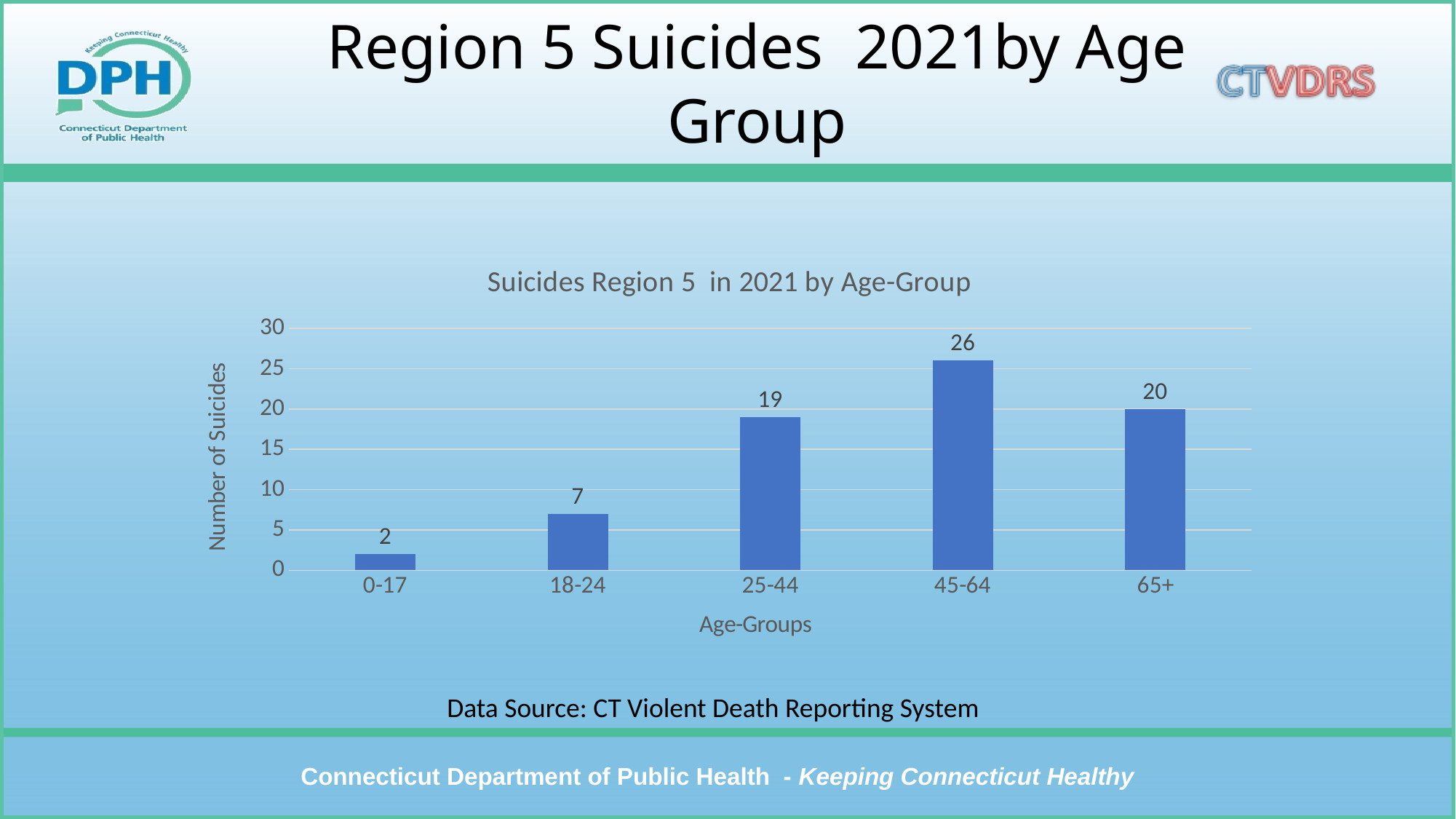
Which age group has the lowest number of suicides? 0-17 What is the title of the chart? Suicides Region 5 in 2021 by Age-Group What is the label of the y axis? Number of Suicides What is the value for the 65+ age group? 20 How many suicides are shown for the 45-64 age group? 26 How many age groups are shown on the x axis? 5 Is the value for the 25-44 age group greater or less than 15? greater Which age group has more suicides, 18-24 or 65+? 65+ What is the number of suicides for the 0-17 age group? 2 What kind of chart is shown on the slide? Bar chart What is the difference between the number of suicides for the 45-64 and 25-44 age groups? 7 Which age group has the highest number of suicides? 45-64